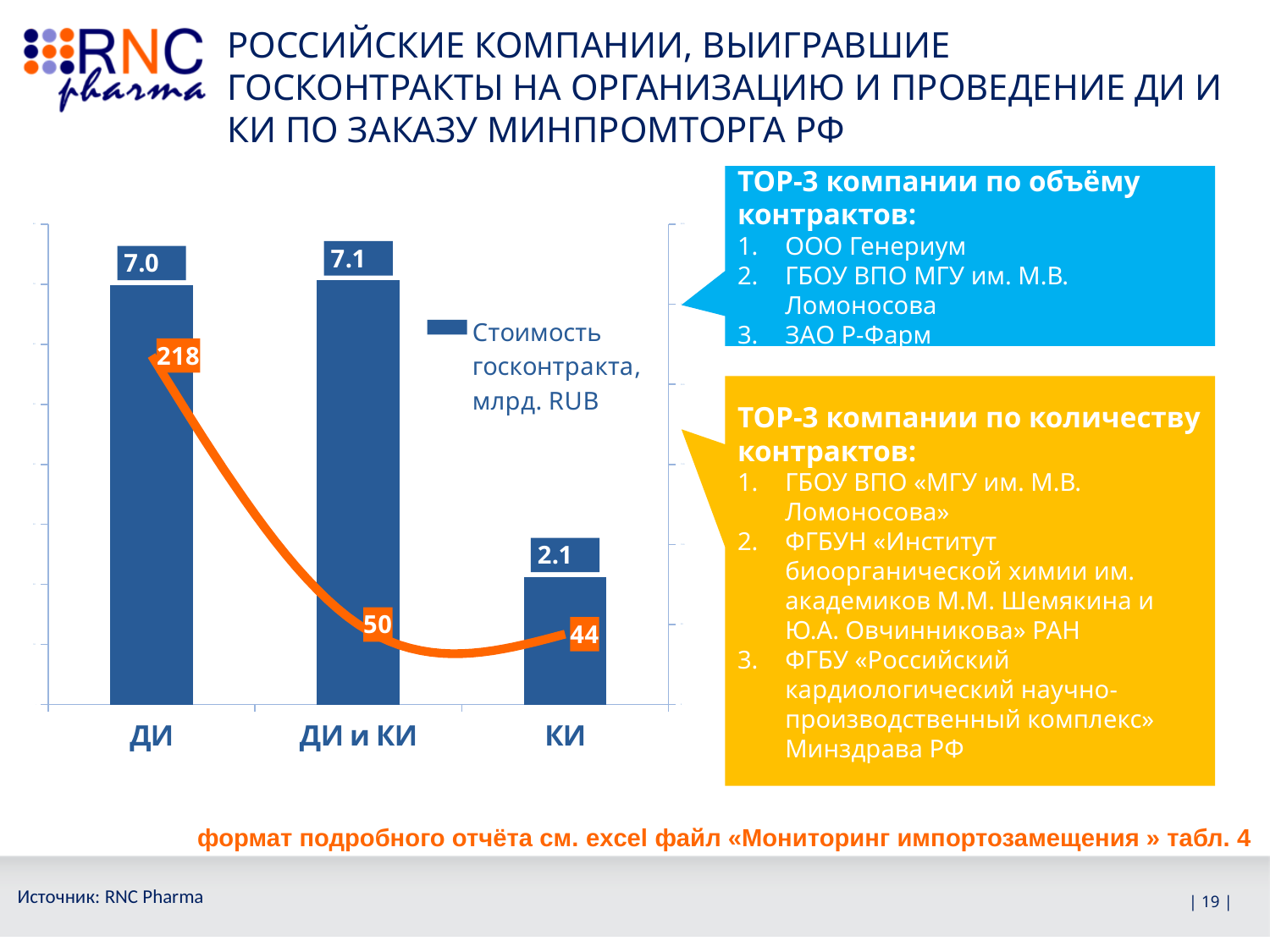
How many categories are shown on the x axis? 3 Which category has the lowest bar value? КИ What does the legend say the bars represent? Стоимость госконтракта, млрд. RUB What is the value of the bar for КИ? 2.1 What is the value of the bar for ДИ и КИ? 7.1 What value does the orange line show for ДИ? 218 Which category has the highest value on the orange line? ДИ What value does the orange line show for КИ? 44 What is the difference between the orange line values for ДИ and ДИ и КИ? 168 Which is larger on the orange line: the value for ДИ и КИ or the value for КИ? ДИ и КИ What is the difference between the bar values for ДИ и КИ and КИ? 5.0 What is the value of the bar for ДИ? 7.0